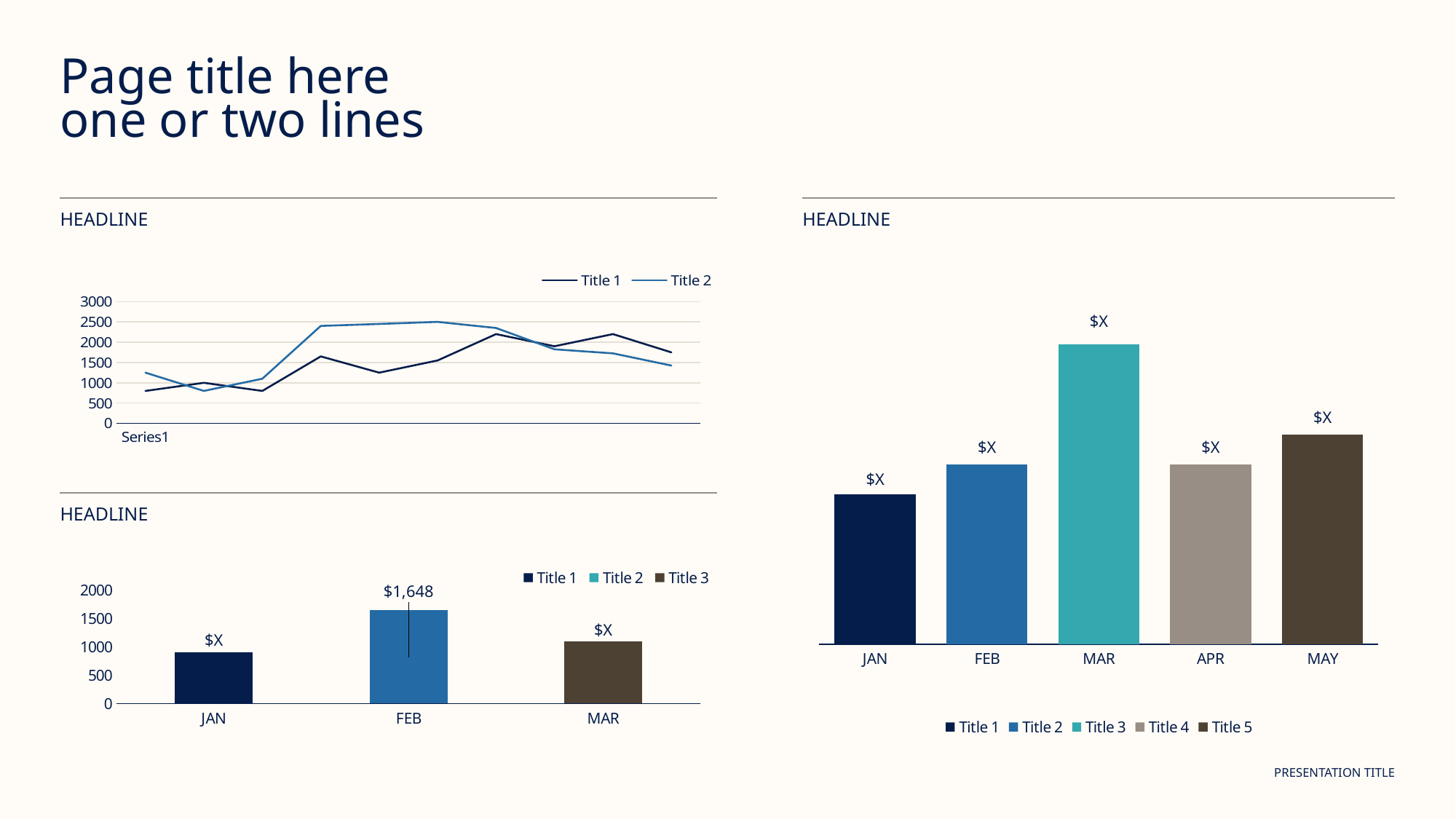
In the bottom-left bar chart, which month has the lowest value? JAN In the bottom-left bar chart, is the value for JAN greater or less than 1000? less In the bottom-left bar chart, what is the value for FEB? $1,648 In the top-left line chart, is the highest value of Title 2 greater or less than 2000? greater How many series does the legend of the top-left line chart list? 2 What type of chart is the top-left chart? line chart In the right-hand bar chart, which month has the highest bar? MAR How many series does the legend of the bottom-left bar chart list? 3 In the top-left line chart, is the first value of Title 1 greater or less than 1000? less How many categories are shown on the x axis of the right-hand bar chart? 5 In the right-hand bar chart, which month has the lowest bar? JAN In the bottom-left bar chart, which month has the highest value? FEB